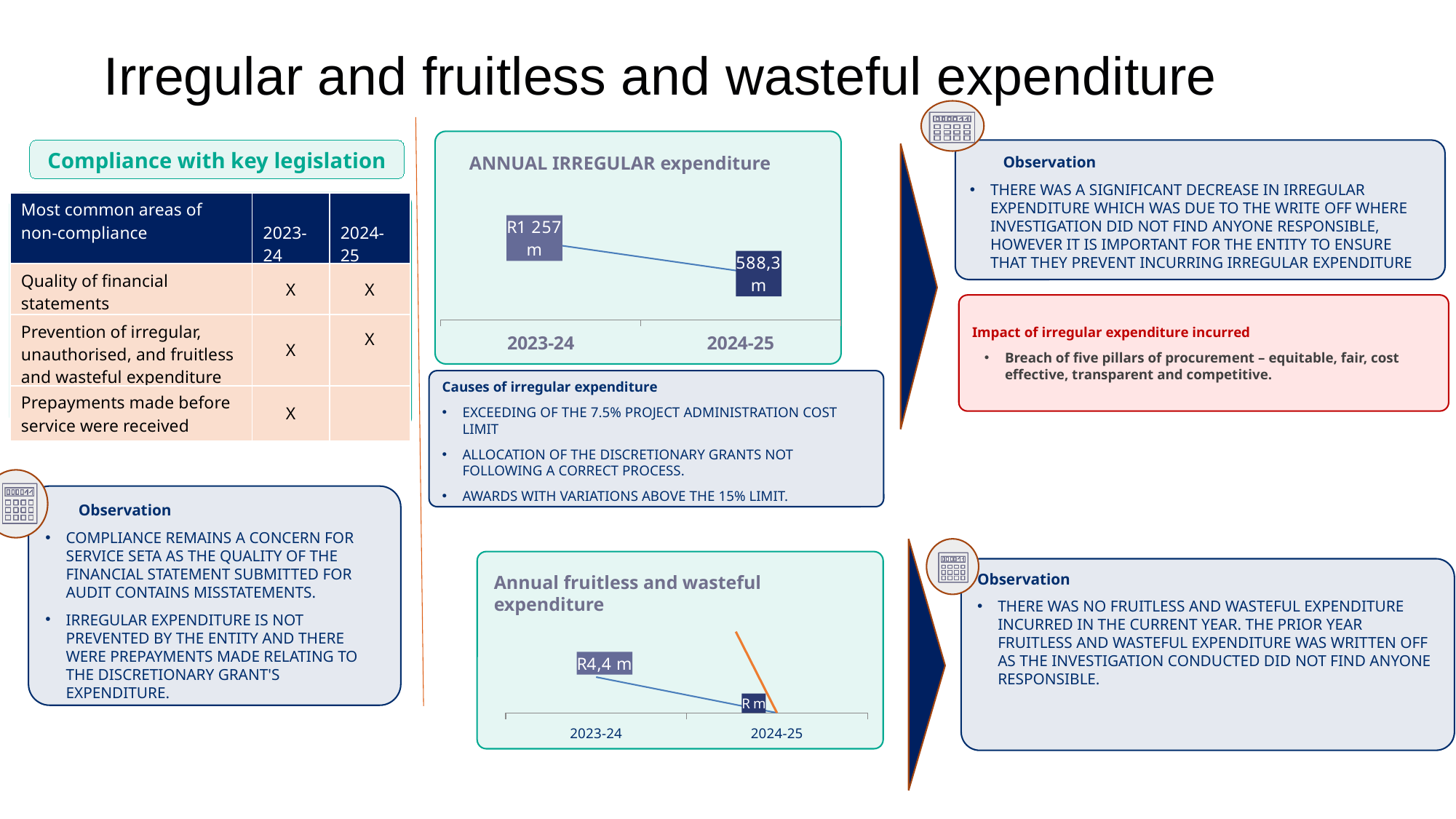
In the Annual fruitless and wasteful expenditure chart, which year has the higher value? 2023-24 In the ANNUAL IRREGULAR expenditure chart, what is the value for 2024-25? 588,3 m How many years are plotted in the ANNUAL IRREGULAR expenditure chart? 2 In the ANNUAL IRREGULAR expenditure chart, which year has the higher value? 2023-24 What is the title of the chart at the bottom centre of the slide? Annual fruitless and wasteful expenditure In the ANNUAL IRREGULAR expenditure chart, which year has the lowest value? 2024-25 In the ANNUAL IRREGULAR expenditure chart, do the values rise or fall from 2023-24 to 2024-25? fall In the ANNUAL IRREGULAR expenditure chart, what is the value for 2023-24? R1 257 m In the Annual fruitless and wasteful expenditure chart, do the values rise or fall from 2023-24 to 2024-25? fall What kind of chart is the ANNUAL IRREGULAR expenditure chart? line chart In the ANNUAL IRREGULAR expenditure chart, by how much does the value decrease from 2023-24 to 2024-25? 668,7 m In the Annual fruitless and wasteful expenditure chart, what is the value for 2023-24? R4,4 m